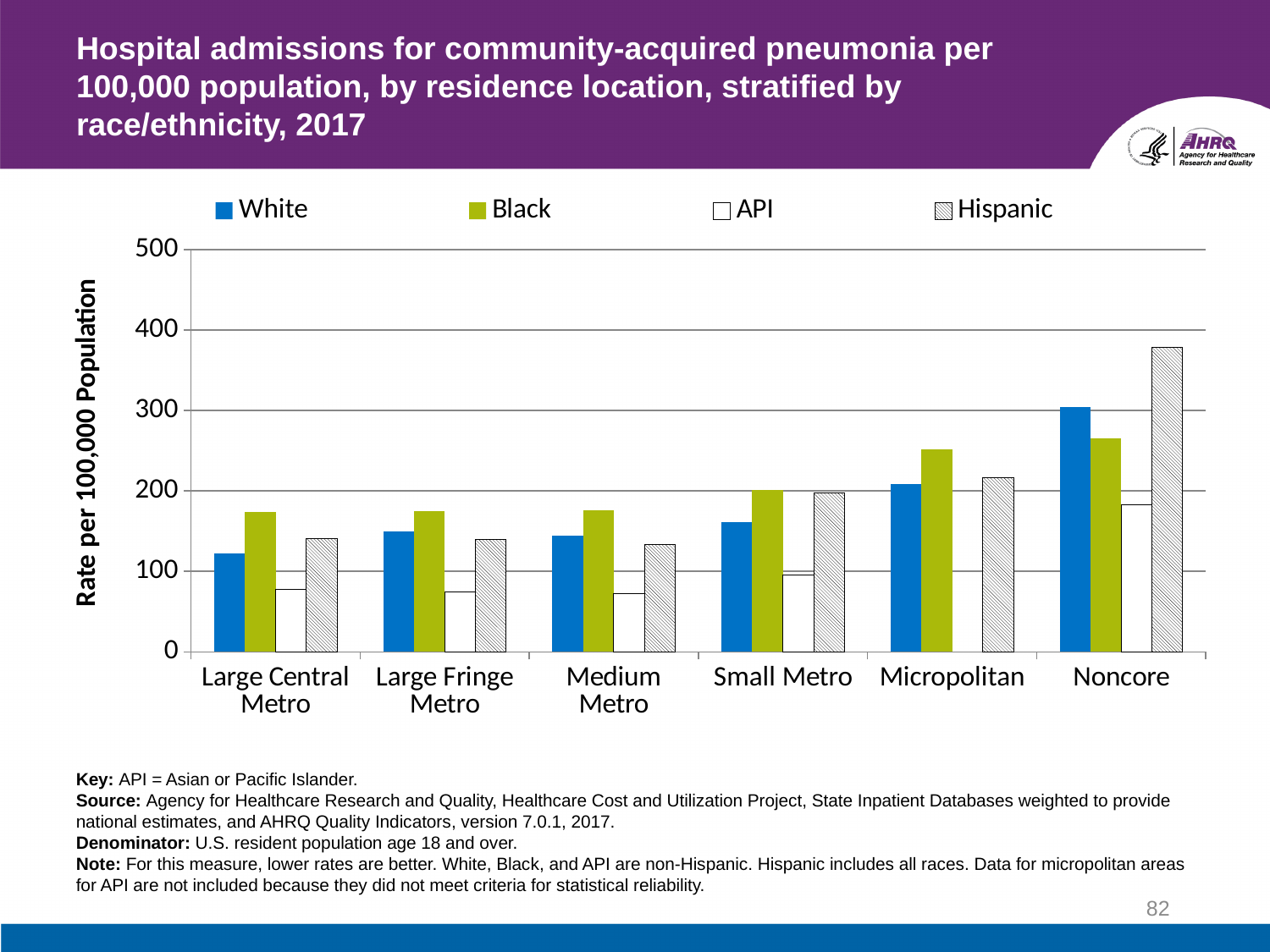
Is the Black value for Micropolitan greater or less than 200? greater What is the title of the y axis? Rate per 100,000 Population Which residence location has the lowest White rate? Large Central Metro Which residence location has no API bar shown? Micropolitan How many residence location categories are shown on the x axis? 6 For Noncore, which is larger, the White rate or the Black rate? White How many series does the legend list? 4 Is the Hispanic value for Noncore greater or less than 300? greater What kind of chart is shown on the slide? bar chart Which residence location has the highest Hispanic rate? Noncore Is the API value for Large Central Metro greater or less than 100? less For Large Central Metro, which is larger, the Black rate or the Hispanic rate? Black